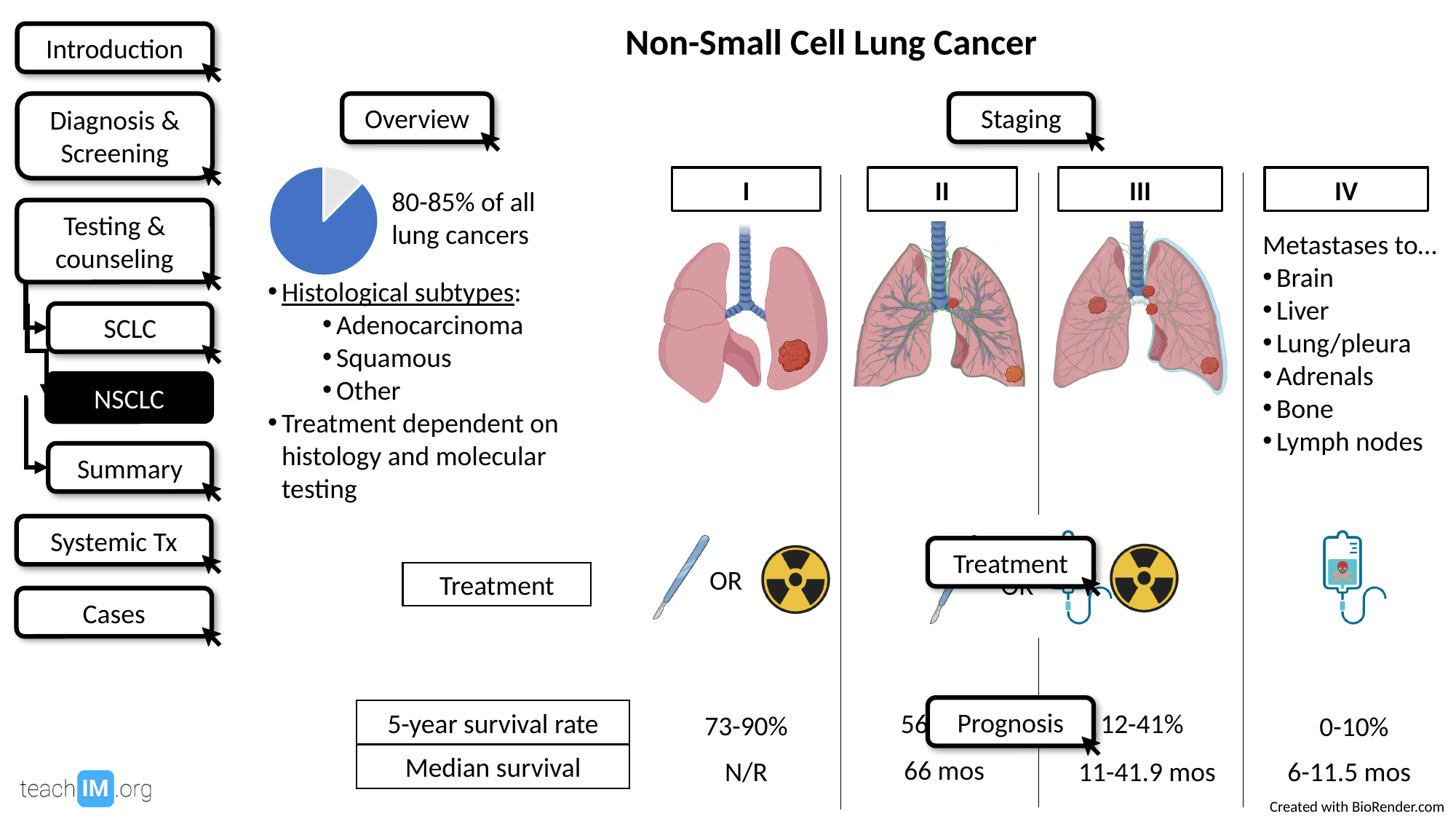
How many slices does the pie chart in the Overview section have? 2 What colour is the larger slice of the pie chart? blue Does the pie chart on the slide have a legend? No What kind of chart is shown in the Overview section of the slide? pie chart Is the share represented by the blue slice of the pie chart greater or less than 50%? greater In the pie chart, which slice is larger, the blue slice or the grey slice? the blue slice According to the text next to the pie chart, what share of all lung cancers does the large blue slice represent? 80-85%